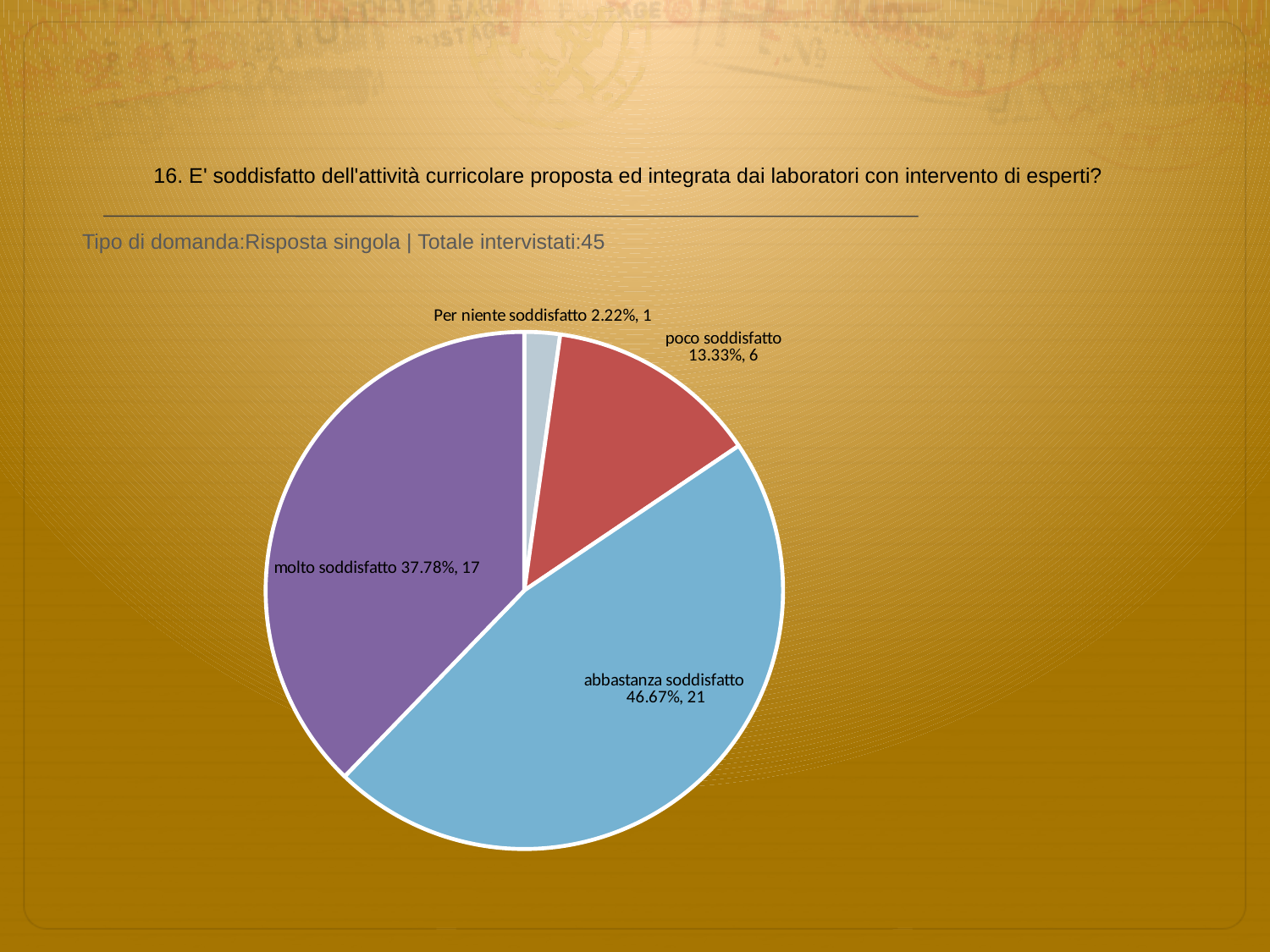
What is the count for "poco soddisfatto"? 6 How many slices does the pie chart have? 4 Which category has the largest slice? abbastanza soddisfatto What percentage share does "Per niente soddisfatto" have? 2.22% What is the difference in count between "abbastanza soddisfatto" and "molto soddisfatto"? 4 What is the total number of respondents across all slices? 45 What is the count for "abbastanza soddisfatto"? 21 What percentage share does "molto soddisfatto" have? 37.78% What colour is the "molto soddisfatto" slice? purple What kind of chart is shown on the slide? pie chart Which category has the smallest slice? Per niente soddisfatto Which is larger, the count for "poco soddisfatto" or for "Per niente soddisfatto"? poco soddisfatto